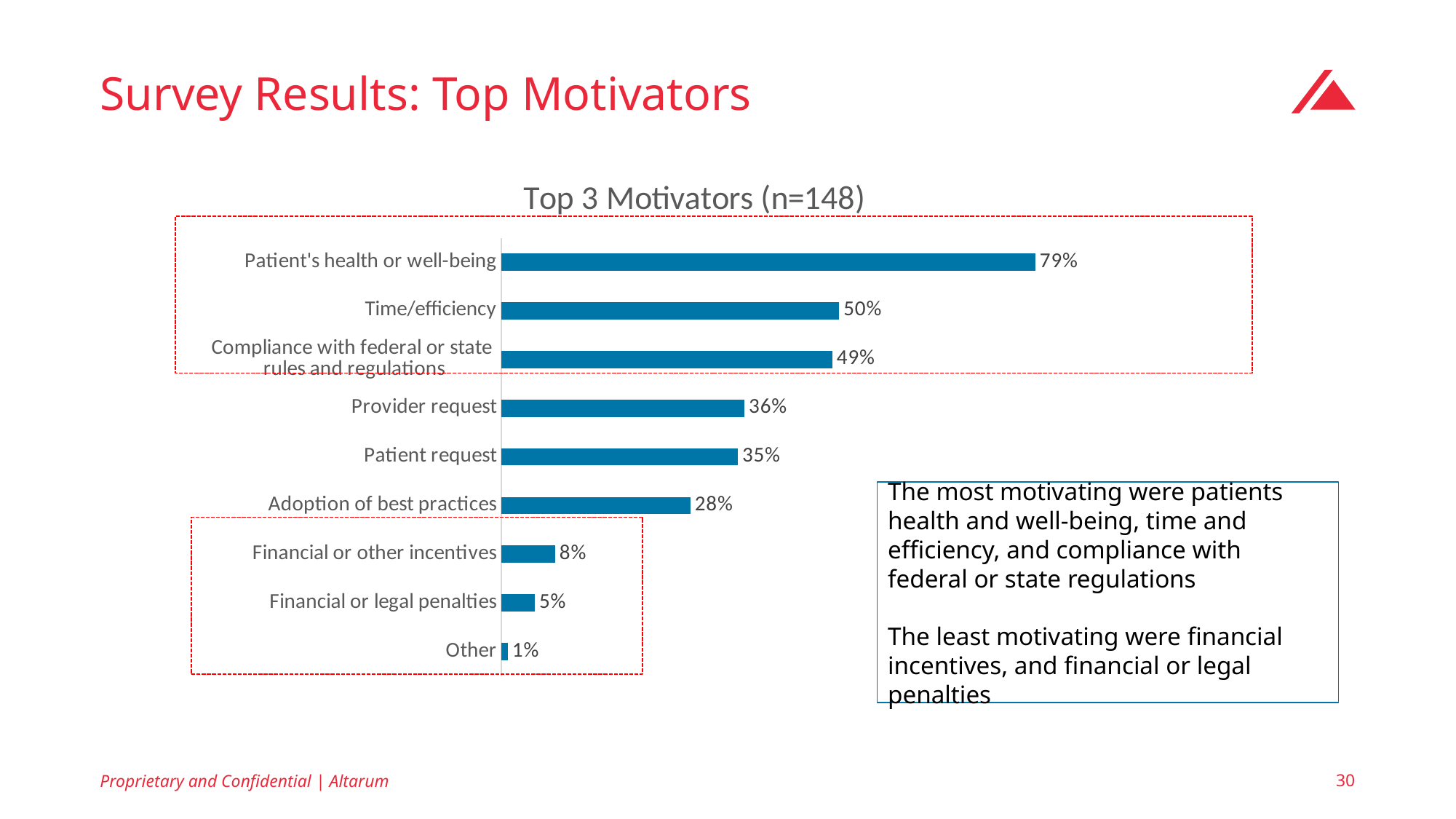
What is the value for Compliance with federal or state rules and regulations? 49% What is the value for Patient's health or well-being? 79% What is the value for Adoption of best practices? 28% Which is larger, the value for Provider request or the value for Adoption of best practices? Provider request What is the title of the chart? Top 3 Motivators (n=148) Which category has the highest value? Patient's health or well-being What is the value for Financial or legal penalties? 5% What kind of chart is shown on the slide? Bar chart Which category has the lowest value? Other How many categories are shown in the chart? 9 What is the difference between the values for Patient's health or well-being and Time/efficiency? 29% What is the difference between the values for Financial or other incentives and Financial or legal penalties? 3%